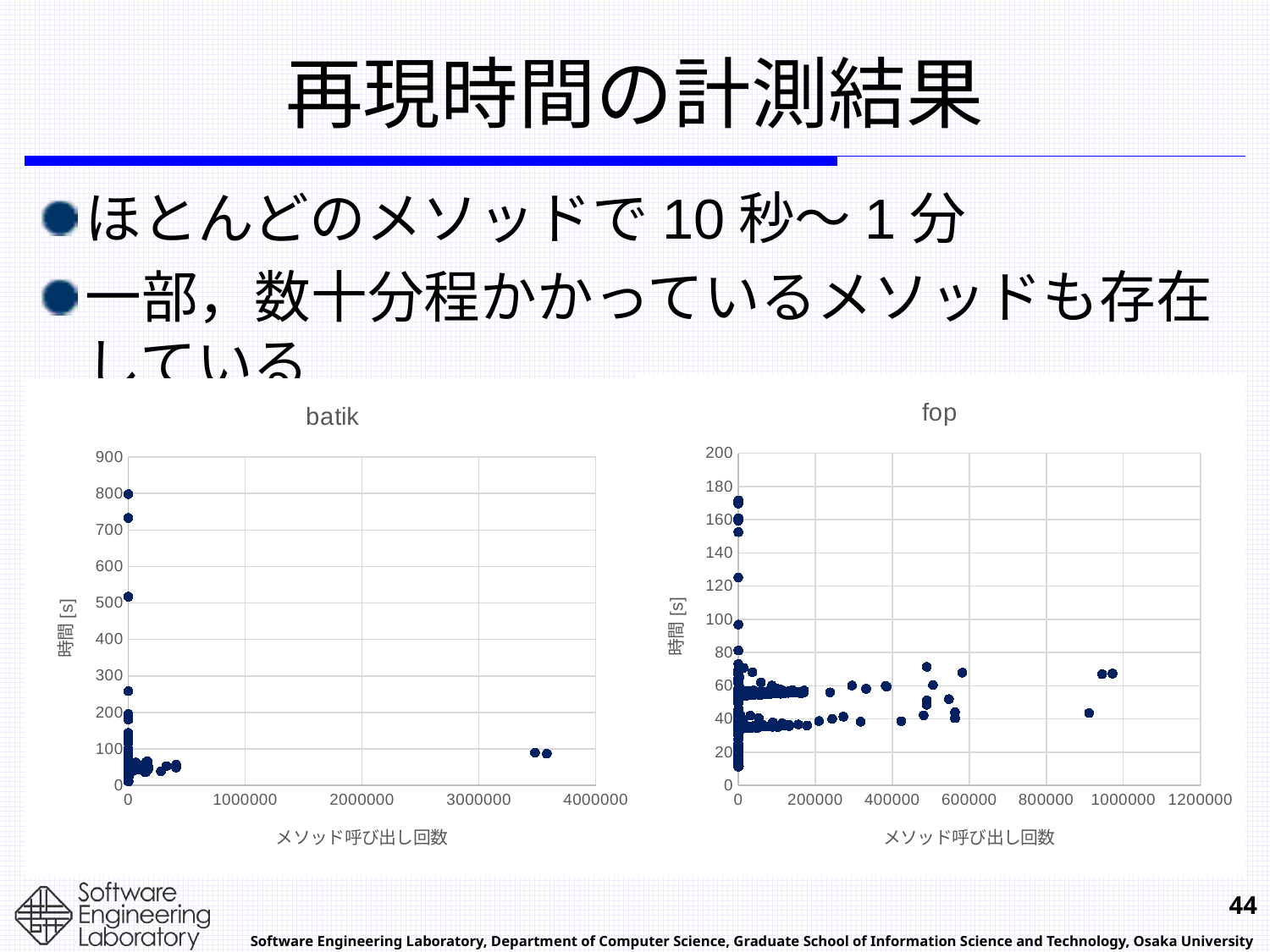
In the "batik" chart, what is the highest tick value shown on the y axis? 900 In the "batik" chart, what is the highest tick value shown on the x axis? 4000000 What is the title of the chart on the left side of the slide? batik What kind of chart is the chart titled "fop"? scatter chart In the "batik" chart, is the time of the highest point greater or less than 700? greater In the "fop" chart, is the time of the highest point greater or less than 150? greater What kind of chart is the chart titled "batik"? scatter chart In the "fop" chart, what is the highest tick value shown on the x axis? 1200000 In the "fop" chart, what is the highest tick value shown on the y axis? 200 In the "batik" chart, are the points near 3500000 method calls greater or less than 200 seconds? less How many charts are shown on the slide? 2 In the "fop" chart, what is the label of the x axis? メソッド呼び出し回数